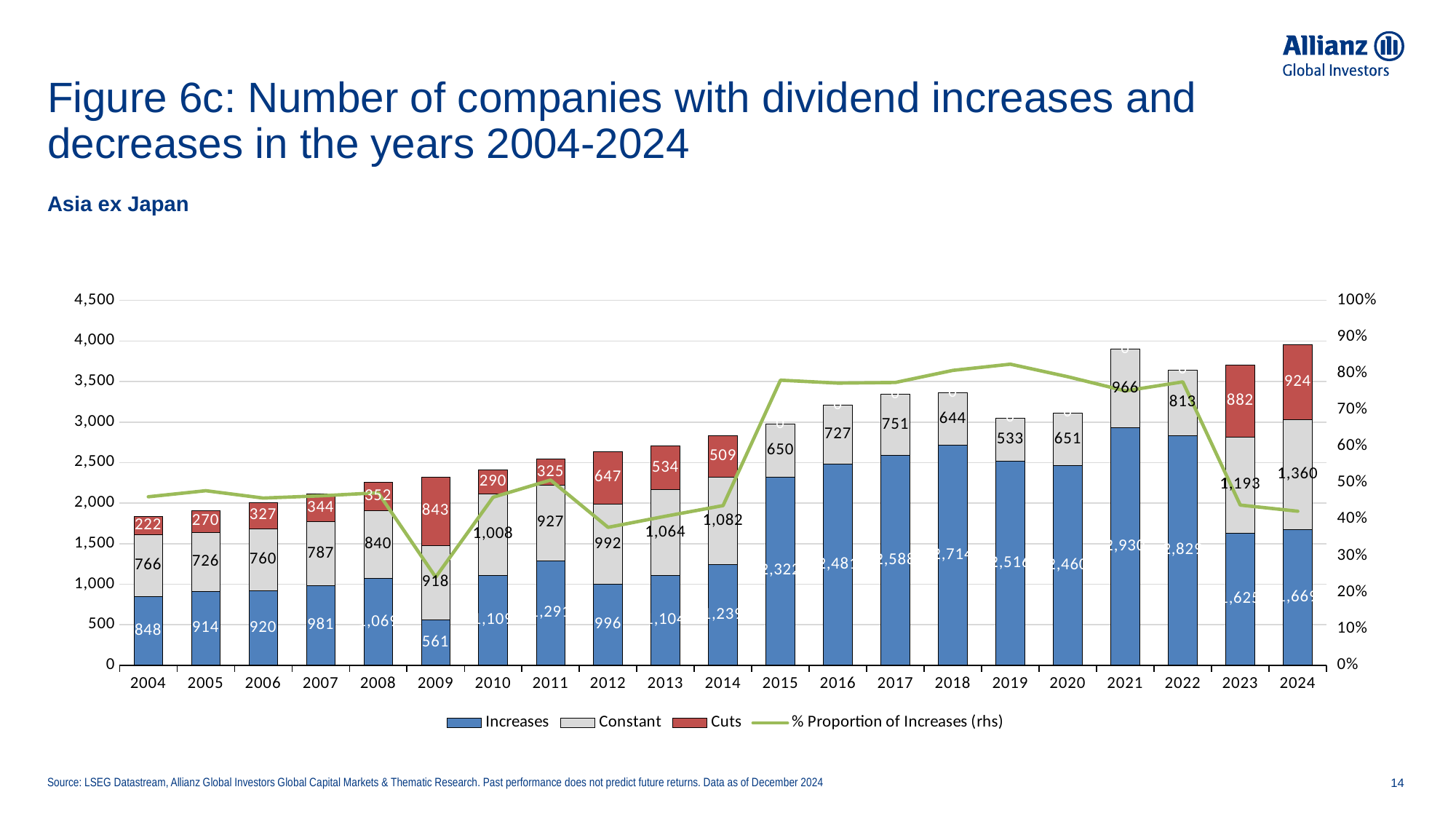
In which year is the Increases value lowest? 2009 What is the total height of the stacked bar for 2004 (Increases + Constant + Cuts)? 1,836 In which year is the Constant value highest? 2024 How many series does the legend list? 4 How many years are shown on the x axis? 21 What is the value of the Cuts series for 2009? 843 How many companies had dividend increases in 2004? 848 What is the difference between the Cuts values for 2024 and 2023? 42 What is the Constant value for 2019? 533 Which is larger, the Constant value for 2012 or for 2013? 2013 In which year is the Cuts value highest? 2024 Is the % Proportion of Increases for 2023 greater or less than 50%? less